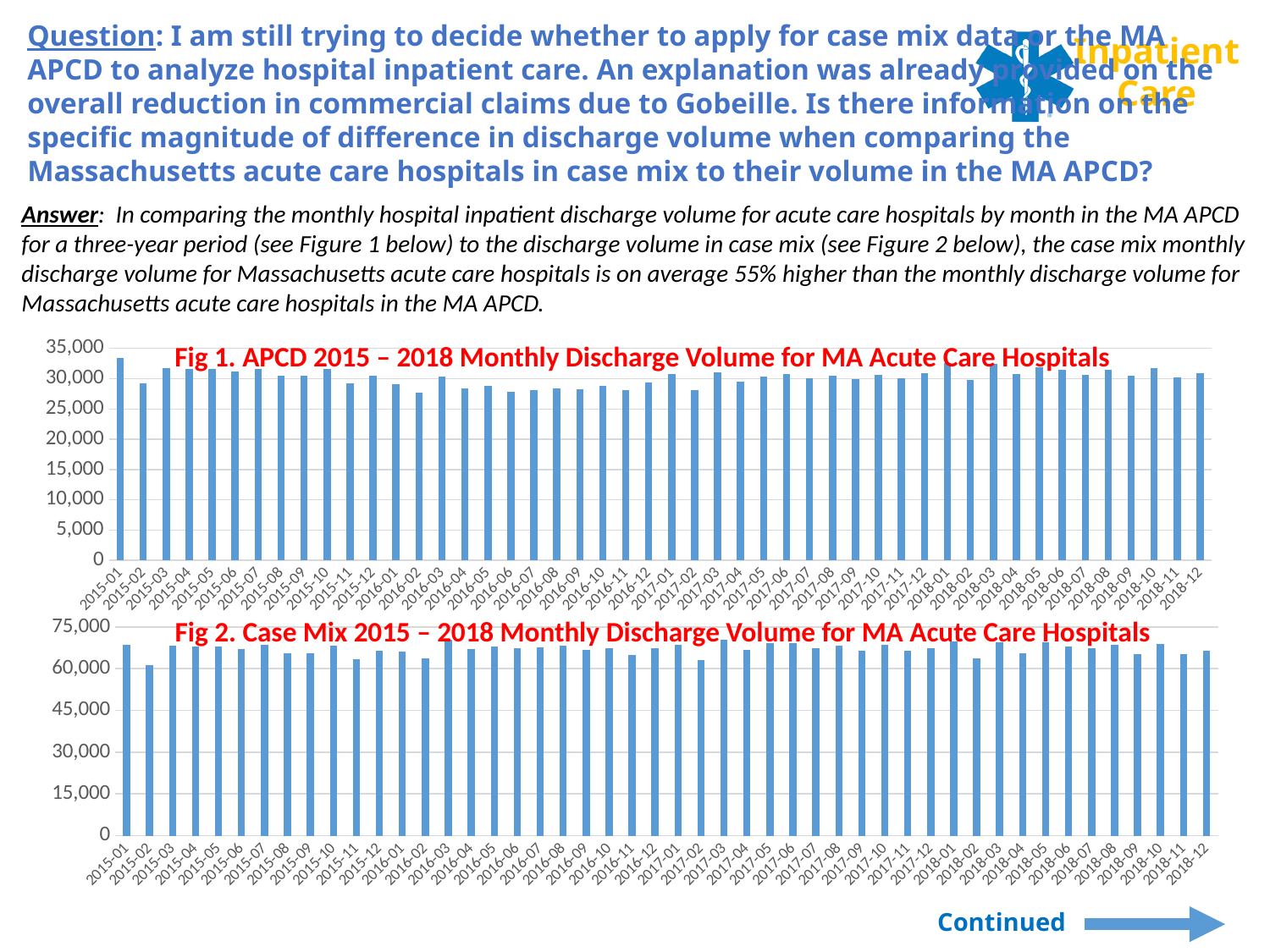
In Fig 2 (Case Mix), how many monthly bars are plotted? 48 In Fig 1 (APCD), is the value for 2016-02 greater or less than 30,000? less In Fig 2 (Case Mix), is the value for 2015-01 greater or less than 60,000? greater In Fig 1 (APCD), how many monthly bars are plotted? 48 What is the title of the lower chart on the slide? Fig 2. Case Mix 2015 – 2018 Monthly Discharge Volume for MA Acute Care Hospitals What kind of chart is Fig 2 (Case Mix 2015 – 2018 Monthly Discharge Volume for MA Acute Care Hospitals)? Bar chart What kind of chart is Fig 1 (APCD 2015 – 2018 Monthly Discharge Volume for MA Acute Care Hospitals)? Bar chart In Fig 1 (APCD), which month has the highest discharge volume? 2015-01 In Fig 1 (APCD), which is larger, the value for 2015-01 or the value for 2015-02? 2015-01 In Fig 2 (Case Mix), which month has the lowest discharge volume? 2015-02 In Fig 1 (APCD), is the value for 2015-01 greater or less than 30,000? greater